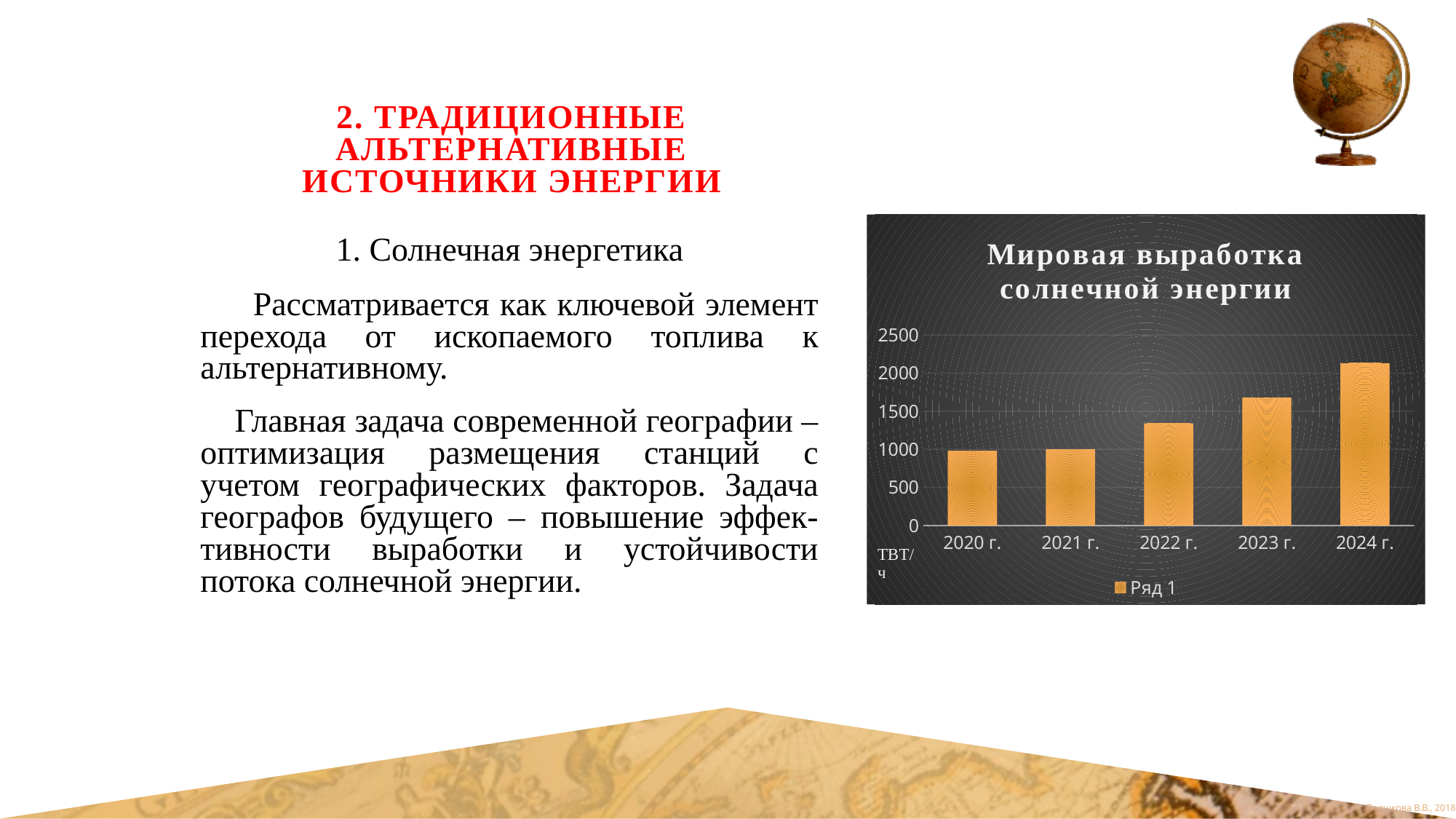
Is the value for 2024 г. greater or less than 2000? greater What kind of chart is shown on the slide? bar chart How many years (categories) are plotted on the chart? 5 What is the name of the series shown in the legend? Ряд 1 Is the value for 2022 г. greater or less than 1000? greater How many series does the chart legend list? 1 Which is larger, the value for 2020 г. or the value for 2024 г.? 2024 г. Which year has the highest value on the chart? 2024 г. Is the value for 2022 г. greater or less than 1500? less What is the title of the chart? Мировая выработка солнечной энергии Do the values rise or fall from 2020 г. to 2024 г.? rise